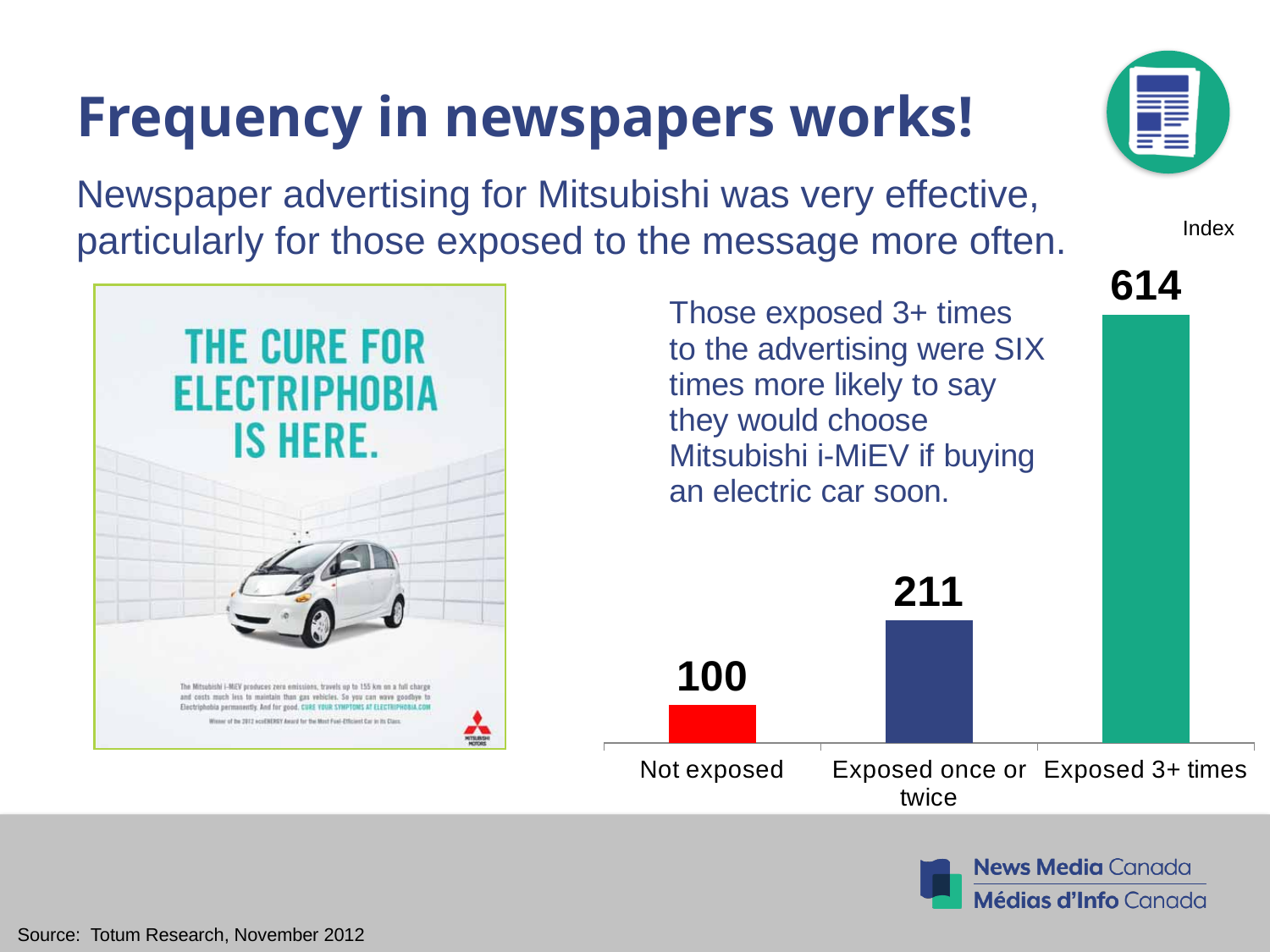
What colour is the bar for 'Not exposed'? Red What is the difference between the index for 'Exposed 3+ times' and 'Exposed once or twice'? 403 What is the index value for the 'Not exposed' group? 100 How many exposure categories are shown in the chart? 3 What is the index value for those exposed once or twice? 211 What kind of chart is shown on the slide? Bar chart What is the index value for those exposed 3+ times? 614 What is the difference between the index for 'Exposed once or twice' and 'Not exposed'? 111 Which exposure group has the highest index value? Exposed 3+ times Which is larger: the index for 'Exposed once or twice' or for 'Not exposed'? Exposed once or twice Which exposure group has the lowest index value? Not exposed Do the index values rise or fall as exposure frequency increases from left to right? Rise